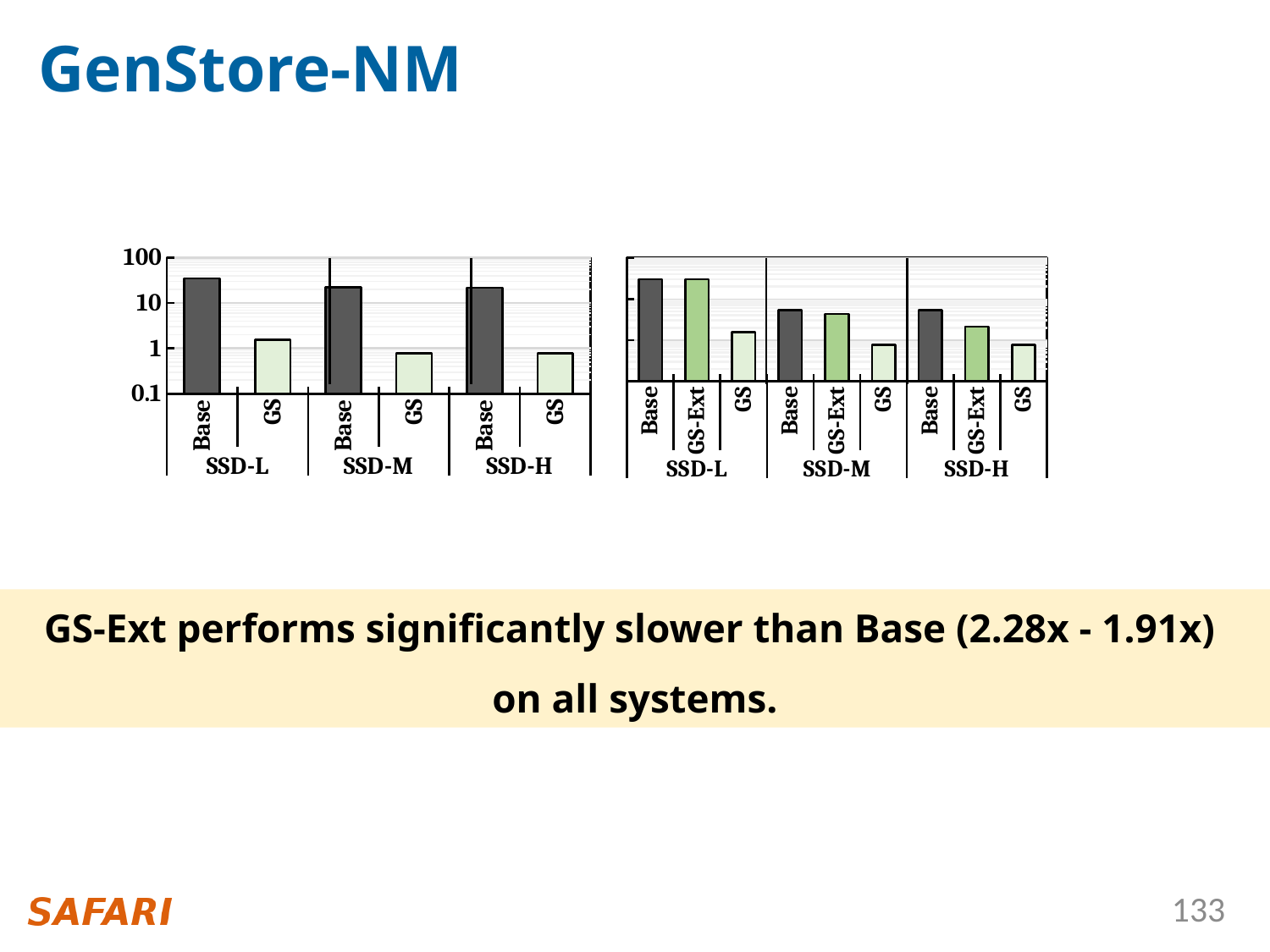
In the left chart, how many SSD configurations (groups) are shown on the x axis? 3 In the left chart, is the Base value for SSD-L greater or less than 10? greater In the left chart, is the Base value for SSD-M greater or less than 10? greater In the left chart, which is larger for SSD-L: Base or GS? Base In the right chart, which is larger for SSD-M: GS-Ext or GS? GS-Ext In the right chart, how many bars are plotted in total? 9 In the left chart, is the GS value for SSD-L greater or less than 10? less What are the tick labels shown on the y axis of the left chart? 0.1, 1, 10, 100 What kind of chart is the left chart on the slide? bar chart In the right chart, which is larger for SSD-H: Base or GS? Base In the left chart, which SSD configuration has the highest Base bar? SSD-L